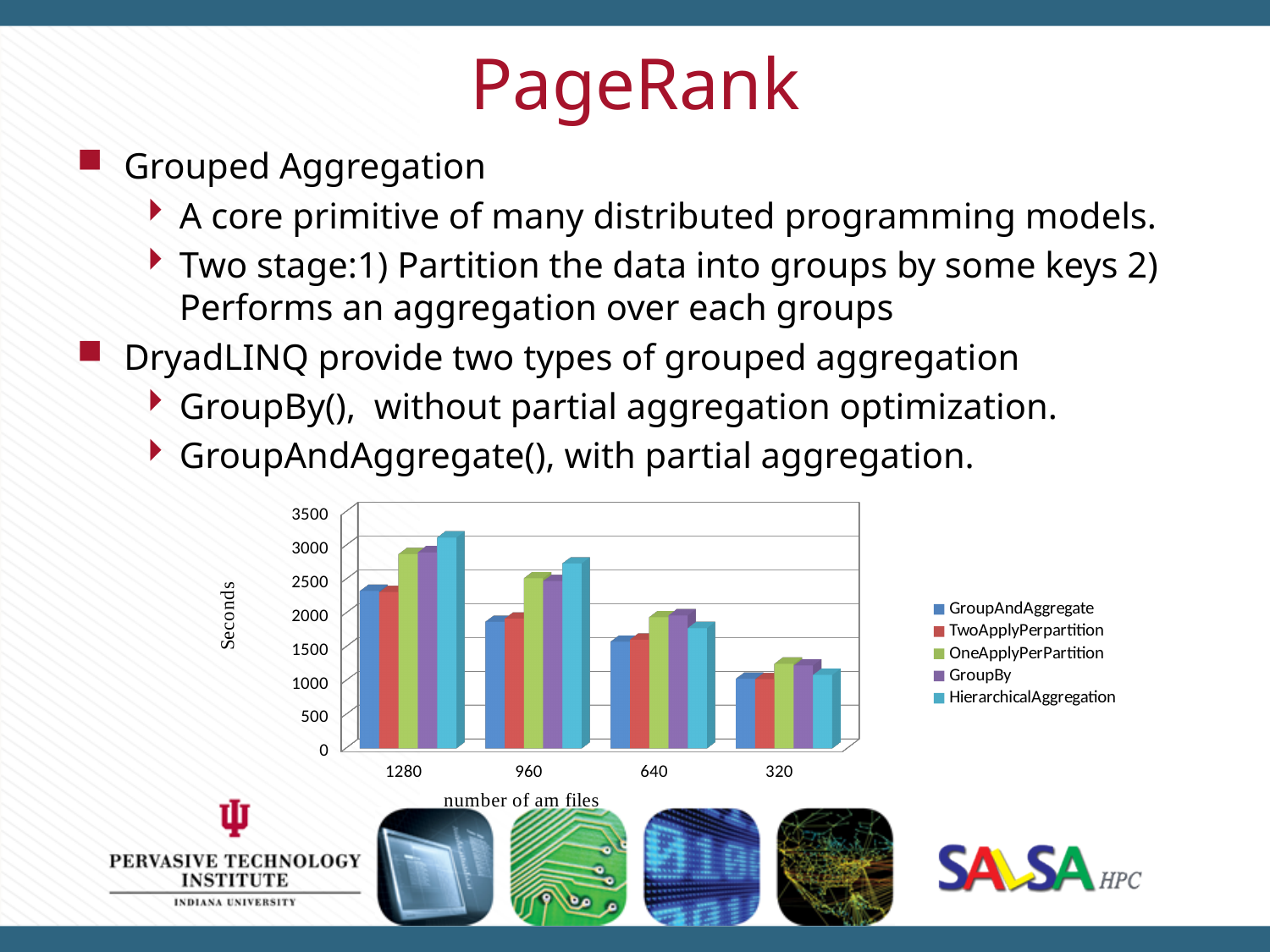
Is the value for OneApplyPerPartition at 960 am files greater or less than 2000? greater Is the value for GroupAndAggregate at 1280 am files greater or less than 2000? greater At 960 am files, which is larger: OneApplyPerPartition or GroupAndAggregate? OneApplyPerPartition What is the label on the horizontal axis of the chart? number of am files How many series does the chart legend list? 5 Which series has the highest value for 1280 am files? HierarchicalAggregation Is the value for HierarchicalAggregation at 1280 am files greater or less than 2500? greater How many categories are shown along the x axis of the chart? 4 Do the GroupAndAggregate values rise or fall moving from 1280 to 320 am files along the x axis? fall What kind of chart is shown on the slide? bar chart What is the label on the vertical axis of the chart? Seconds